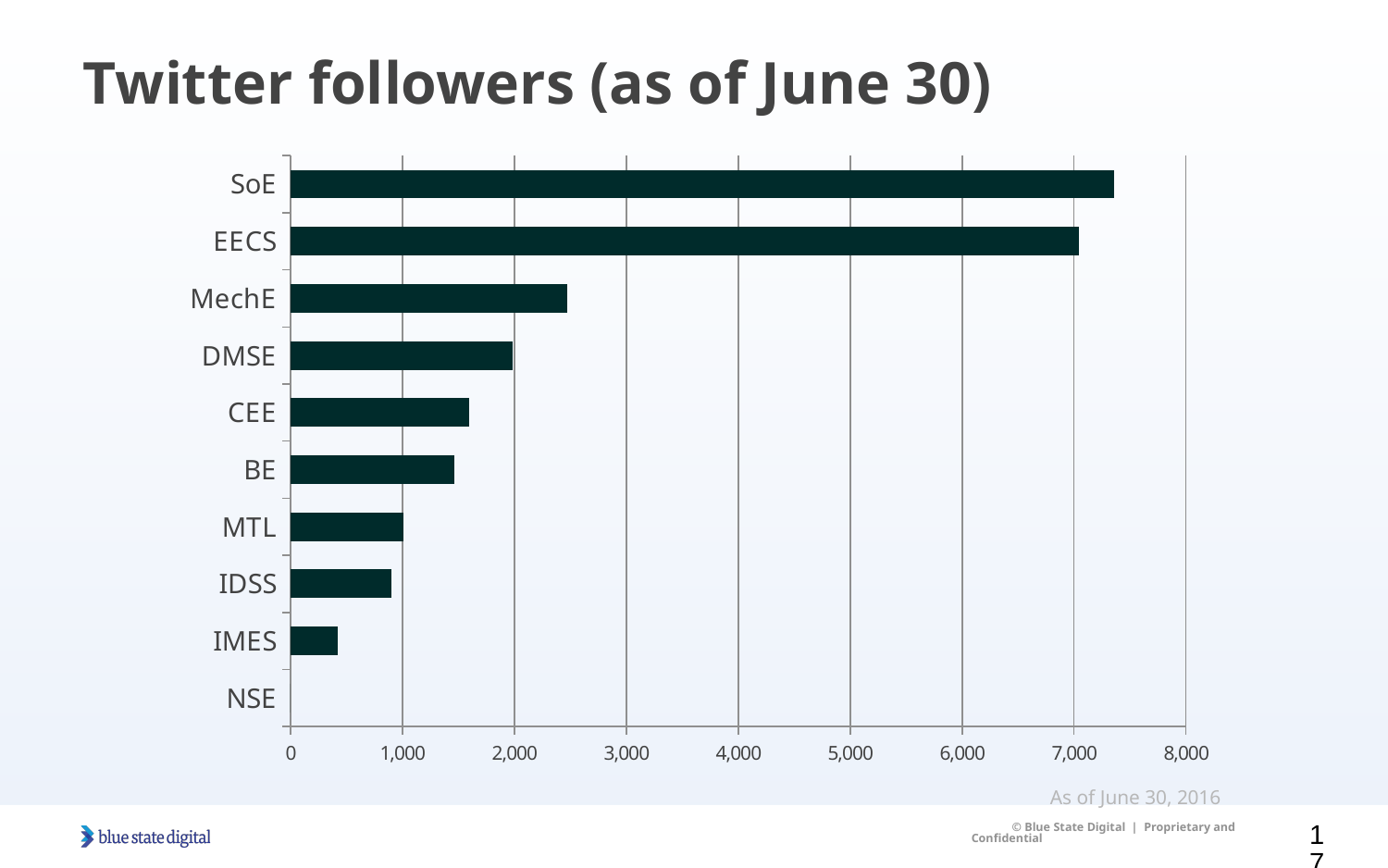
Is the value for MechE greater or less than 2,000? greater Is the value for IMES greater or less than 1,000? less How many categories are shown on the chart? 10 Which category has the most Twitter followers? SoE Which category has the fewest Twitter followers? NSE What kind of chart is shown on the slide? bar chart What is the title of the chart? Twitter followers (as of June 30) Which has more Twitter followers, EECS or MechE? EECS Is the value for MechE greater or less than 3,000? less Which has more Twitter followers, CEE or BE? CEE